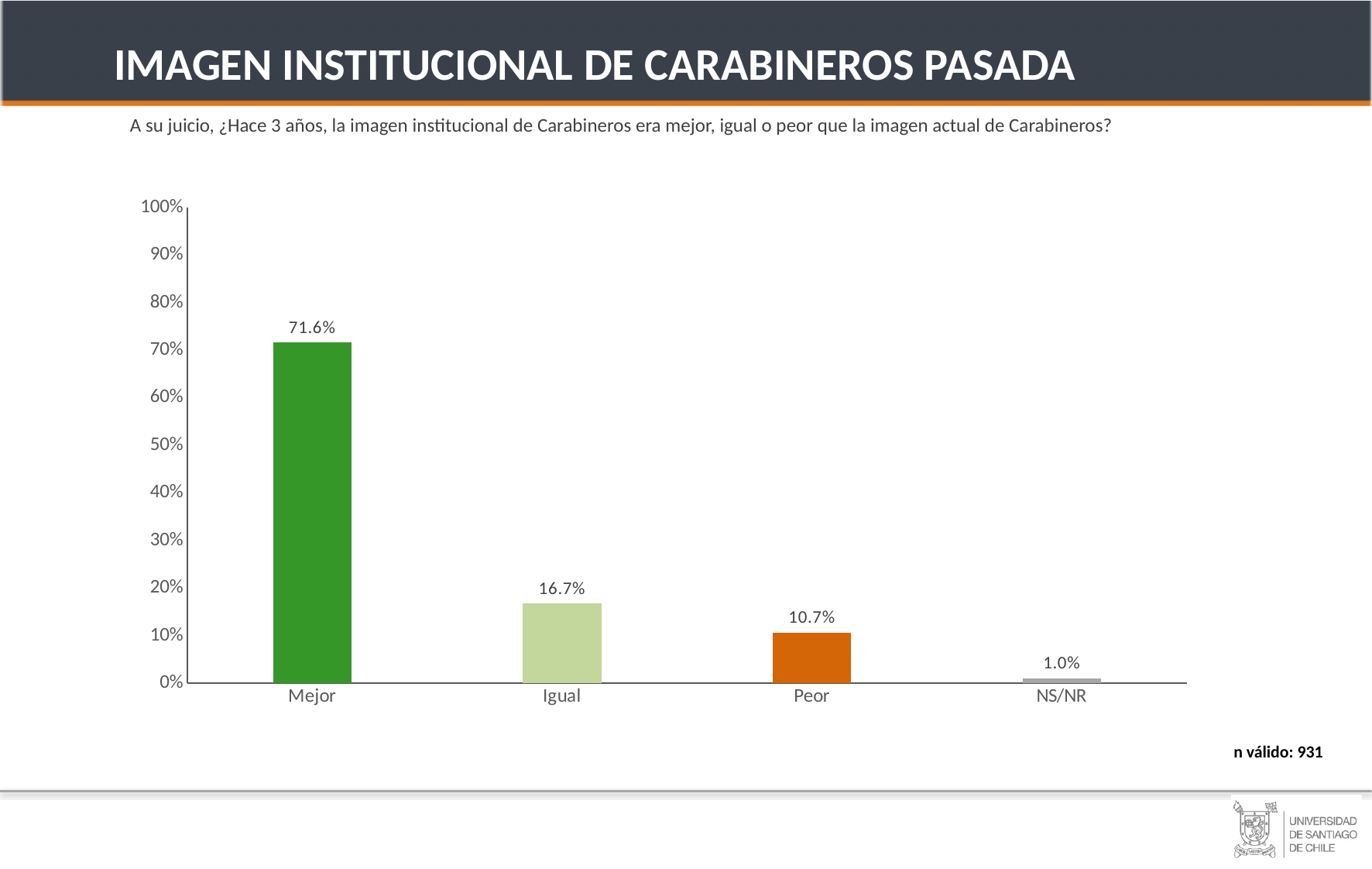
Which category has the lowest value? NS/NR Is the value for Mejor greater or less than 70%? greater How many categories are shown on the x axis? 4 What is the value for Mejor? 71.6% What is the value for Peor? 10.7% What is the difference between the values for Mejor and Igual? 54.9% What kind of chart is shown on the slide? bar chart What is the difference between the values for Igual and Peor? 6.0% What is the value for NS/NR? 1.0% What is the value for Igual? 16.7% Which category has the highest value? Mejor Which is larger, the value for Igual or the value for Peor? Igual